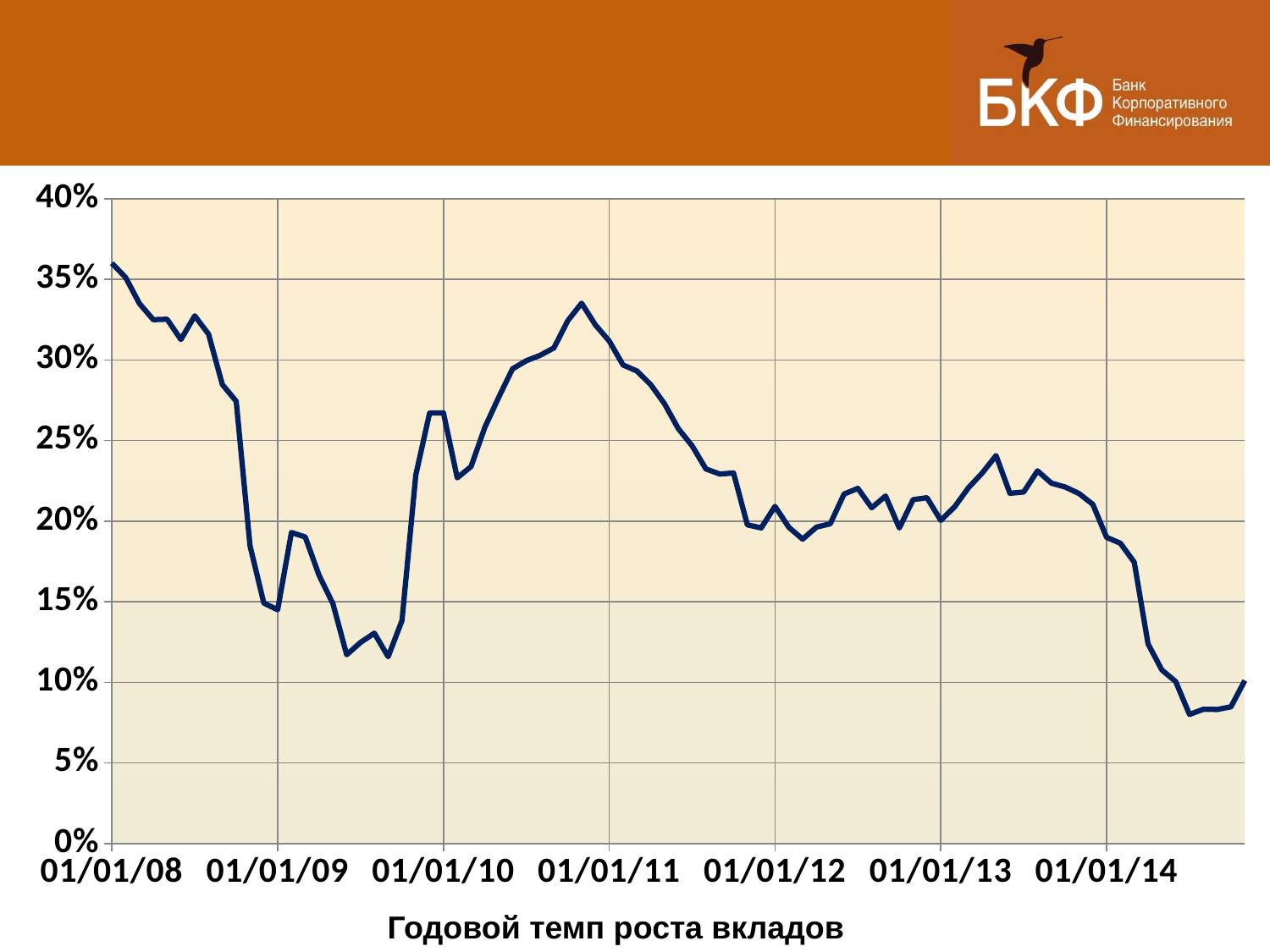
Which x-axis date has the higher value, 01/01/08 or 01/01/09? 01/01/08 How many date labels are shown on the x axis? 7 Is the value at 01/01/08 greater or less than 30%? greater Does the line rise or fall between 01/01/08 and 01/01/09? fall Is the value at the end of the series (right edge) greater or less than 15%? less What kind of chart is shown on the slide? line chart Does the line rise or fall between 01/01/09 and 01/01/10? rise Is the value at 01/01/10 greater or less than 25%? greater What is the title shown below the chart? Годовой темп роста вкладов How many series are plotted on the chart? 1